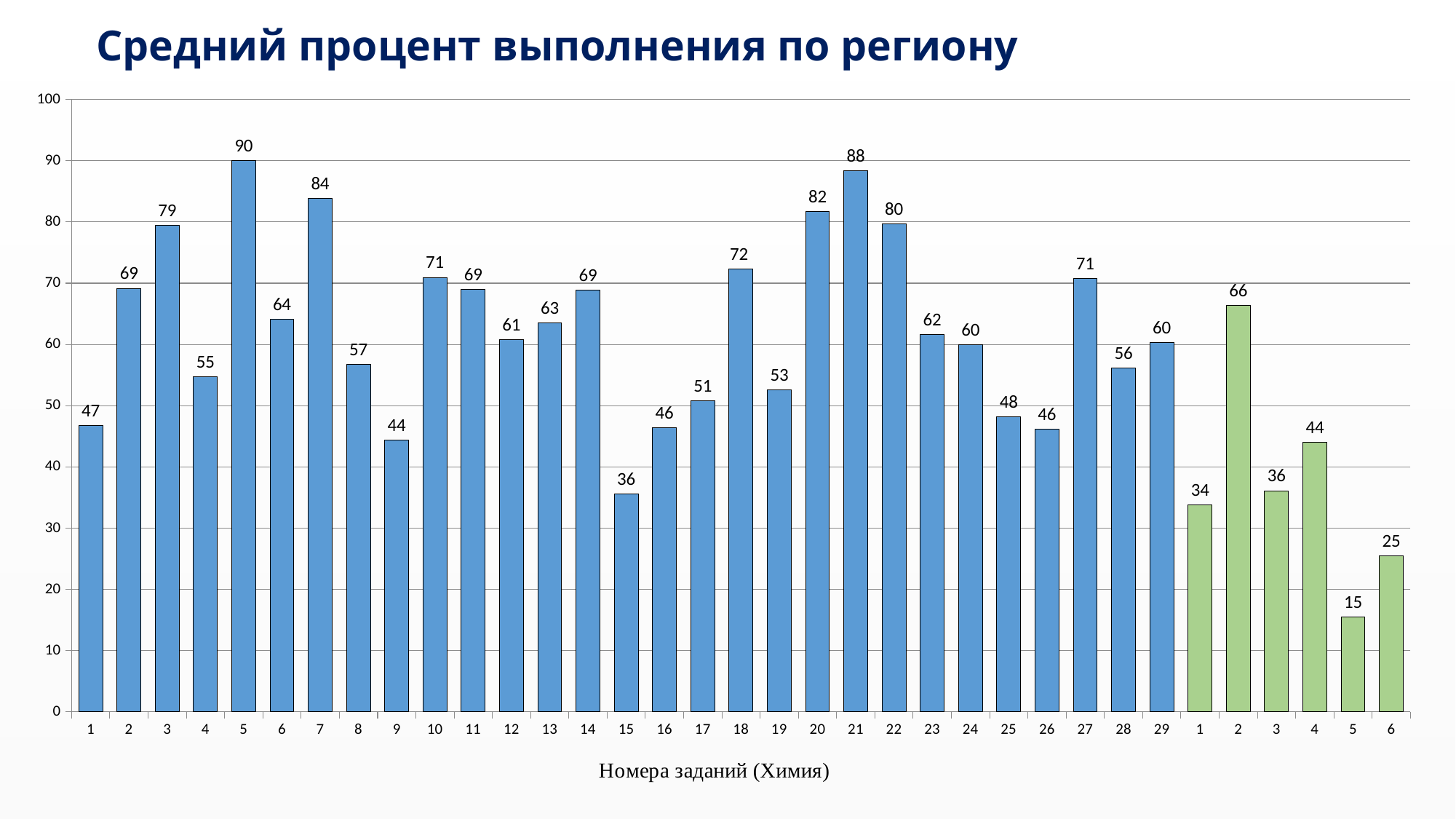
What is the title of the chart? Средний процент выполнения по региону What is the value for blue bar task 5? 90 Which is larger, the value for blue bar task 3 or blue bar task 22? Blue bar task 22 Is the value for blue bar task 9 greater or less than 50? less Which blue bar task has the highest value? 5 How many bars are plotted in the chart in total? 35 What is the difference between the values for blue bar task 5 and blue bar task 15? 54 What kind of chart is shown on the slide? Bar chart What is the value for green bar task 2? 66 How many green bars are there in the chart? 6 Which green bar task has the lowest value? 5 What is the value for blue bar task 21? 88